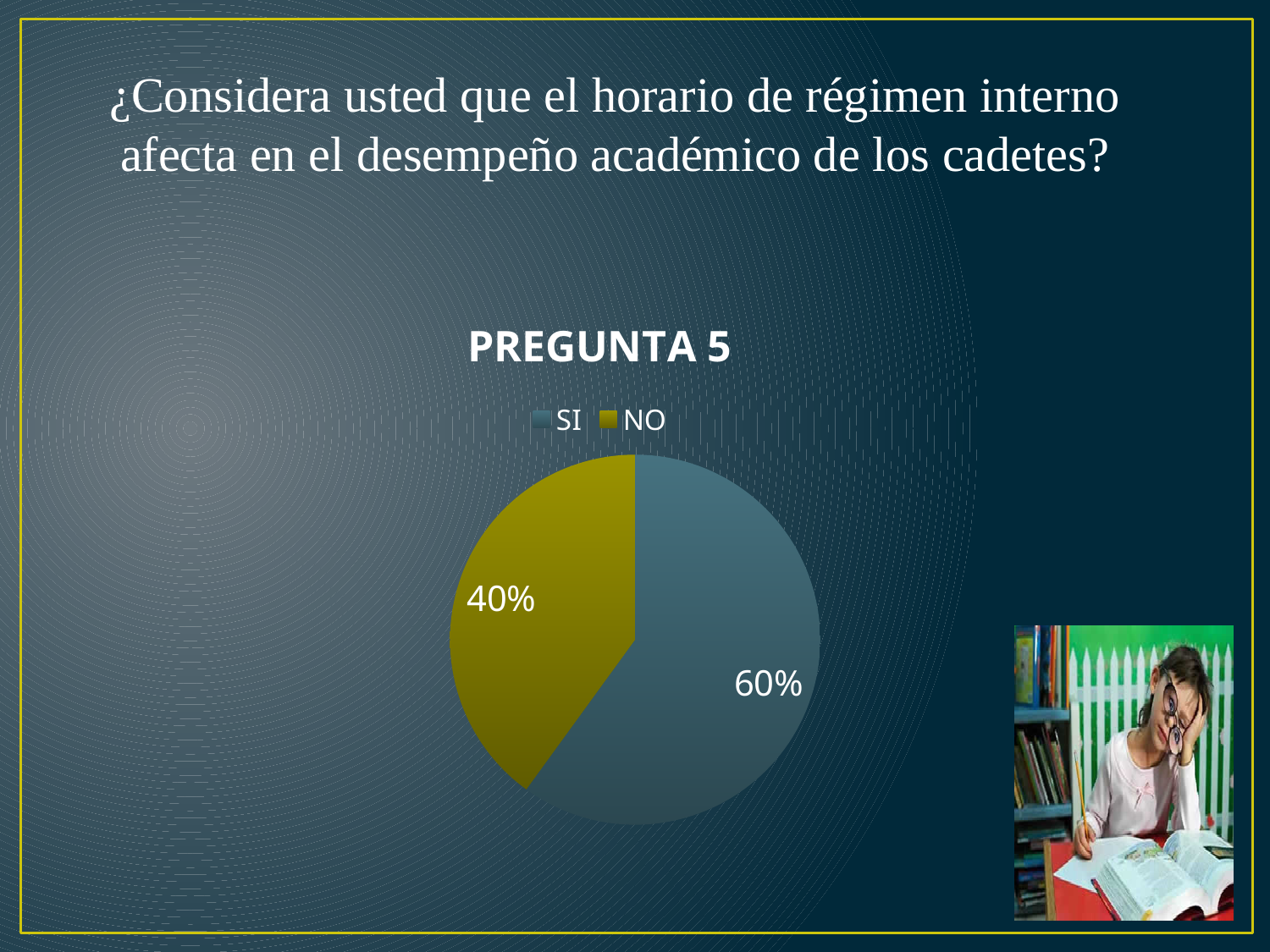
What is the chart's title? PREGUNTA 5 What percentage of the pie is the SI slice? 60% What is the total of the two slices shown? 100% What kind of chart is shown on the slide? pie chart Which slice is the smallest? NO What percentage of the pie is the NO slice? 40% How many entries does the legend list? 2 How many slices does the pie chart have? 2 What is the difference in percentage points between the SI and NO slices? 20% Which is larger, the SI slice or the NO slice? SI What colour is the NO slice? yellow Which slice is the largest? SI